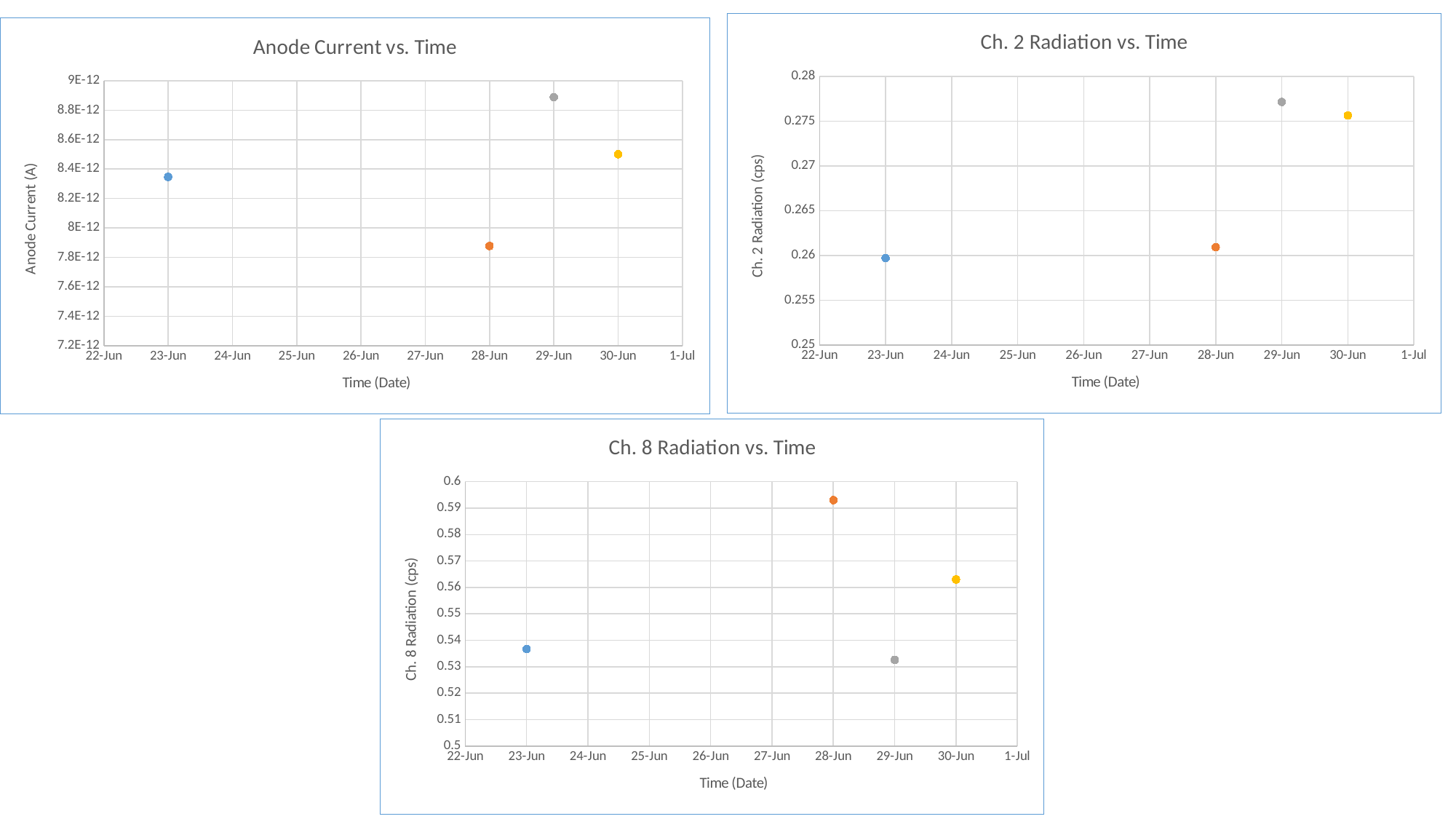
In the "Anode Current vs. Time" chart, is the value for 28-Jun greater or less than 8E-12? less What is the y-axis label of the "Ch. 2 Radiation vs. Time" chart? Ch. 2 Radiation (cps) In the "Ch. 2 Radiation vs. Time" chart, which is larger, the value for 23-Jun or the value for 29-Jun? 29-Jun What kind of chart is the "Anode Current vs. Time" chart? scatter chart In the "Ch. 8 Radiation vs. Time" chart, is the value for 30-Jun greater or less than 0.55? greater In the "Ch. 8 Radiation vs. Time" chart, on which date is the Ch. 8 radiation highest? 28-Jun In the "Ch. 8 Radiation vs. Time" chart, how many data points are plotted? 4 In the "Ch. 2 Radiation vs. Time" chart, is the value for 29-Jun greater or less than 0.275? greater In the "Anode Current vs. Time" chart, on which date is the anode current highest? 29-Jun In the "Anode Current vs. Time" chart, which is larger, the value for 23-Jun or the value for 30-Jun? 30-Jun In the "Anode Current vs. Time" chart, how many data points are plotted? 4 In the "Anode Current vs. Time" chart, on which date is the anode current lowest? 28-Jun